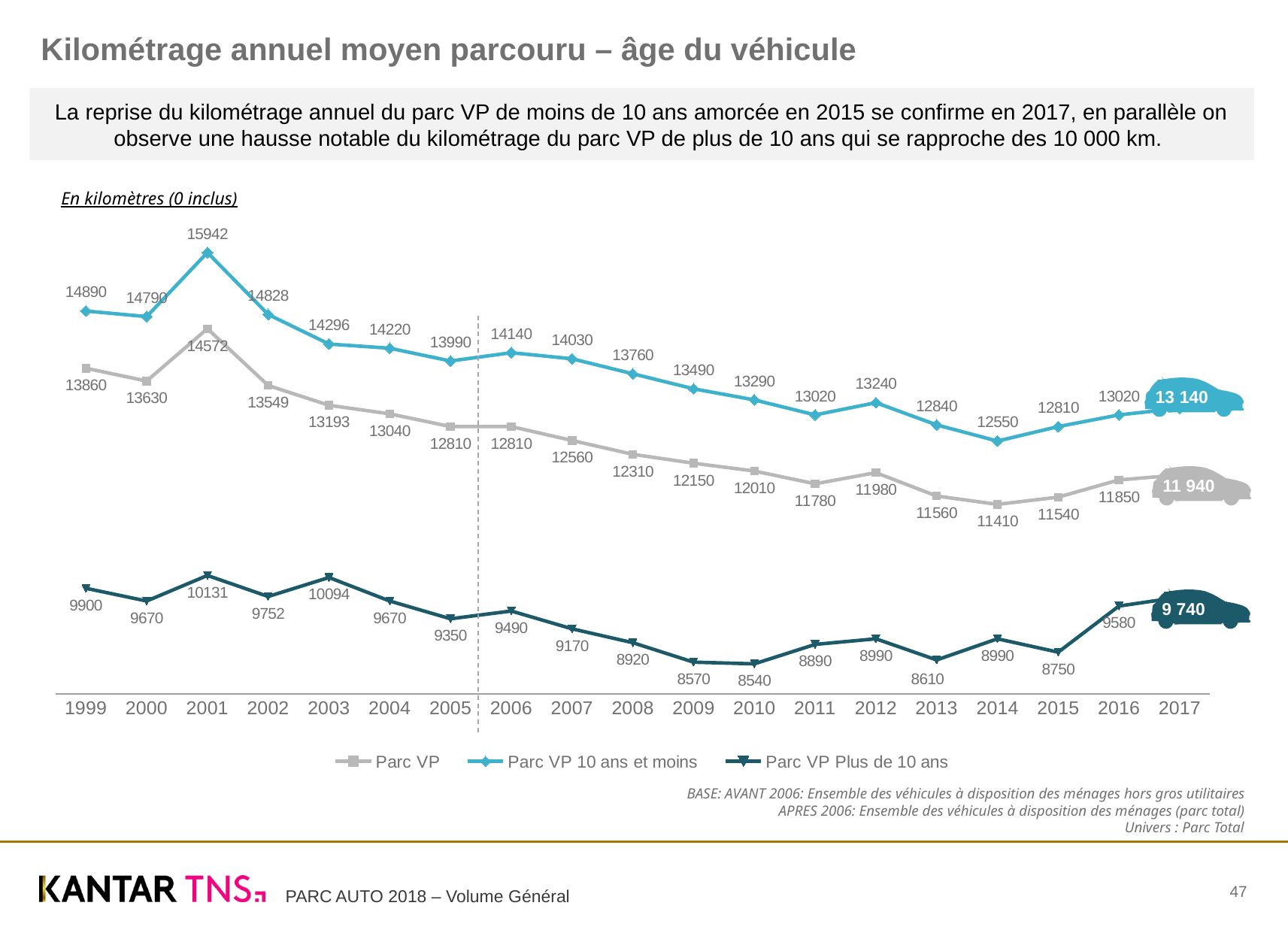
What is the value for Parc VP in 2014? 11410 What is the value for Parc VP 10 ans et moins in 2001? 15942 In which year does the Parc VP 10 ans et moins series reach its highest value? 2001 In which year does the Parc VP Plus de 10 ans series reach its lowest value? 2010 What is the value for Parc VP Plus de 10 ans in 2017? 9 740 What is the difference between Parc VP 10 ans et moins and Parc VP Plus de 10 ans in 2017? 3400 Which is larger in 2012: the value for Parc VP or the value for Parc VP Plus de 10 ans? Parc VP Does the Parc VP series rise or fall between 2006 and 2011? Fall How many series does the legend list? 3 What is the name of the third series listed in the legend? Parc VP Plus de 10 ans What kind of chart is shown on the slide? Line chart How many years are shown on the x axis? 19